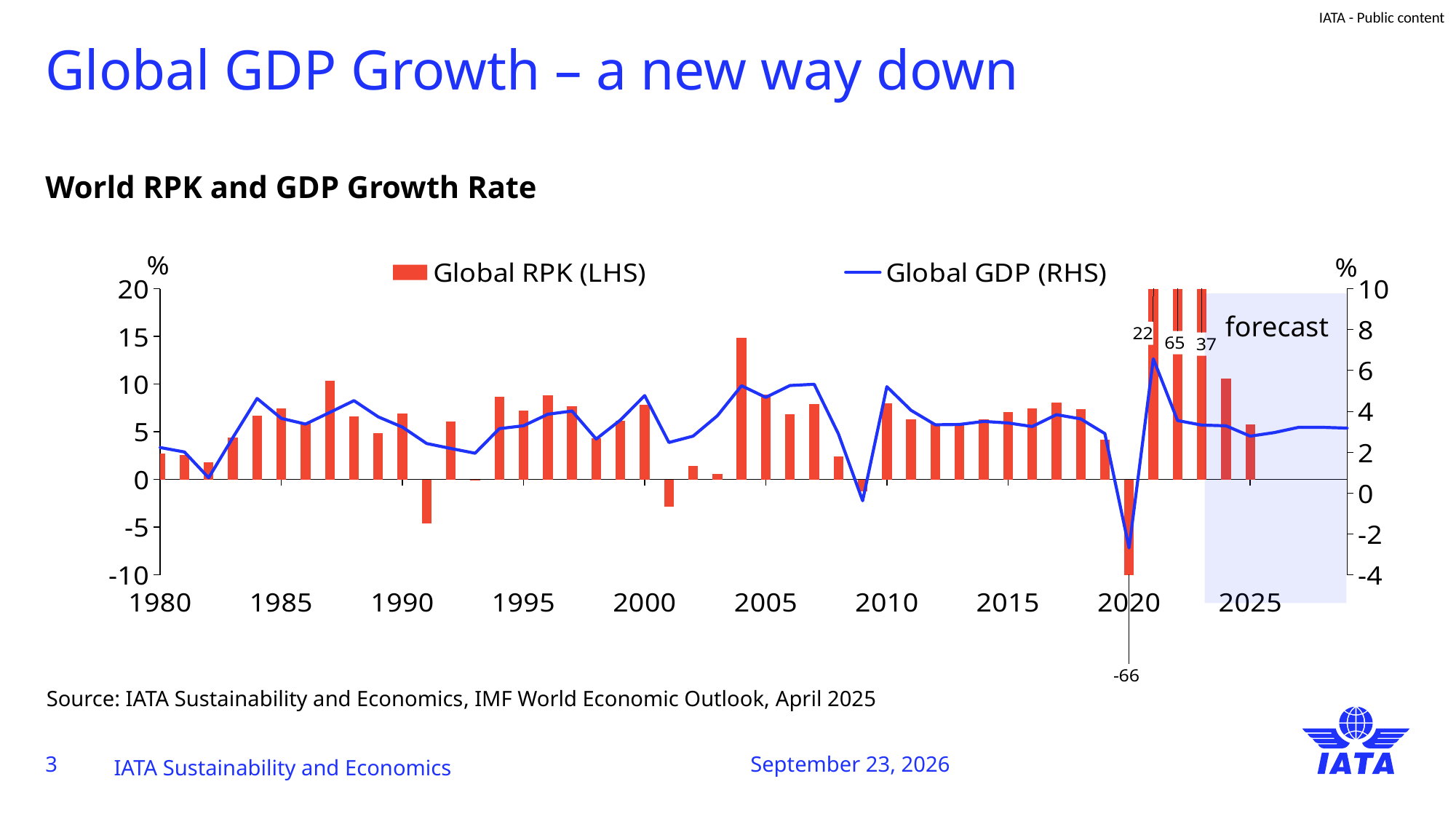
Is the Global RPK value for 2004 greater or less than 10? greater What is the Global RPK growth value labelled for 2023? 37 What is the title of the chart? World RPK and GDP Growth Rate What is the Global RPK growth value labelled for 2020? -66 What is the Global RPK growth value labelled for 2022? 65 How many series does the chart legend list? 2 What kind of chart is shown on the slide? bar and line chart What is the Global RPK growth value labelled for 2021? 22 Which year has the lowest Global RPK growth? 2020 Is the Global RPK value for 2001 greater or less than 0? less What is the difference between the labelled Global RPK values for 2022 and 2023? 28 Which is larger, the Global RPK value for 2004 or for 2005? 2004